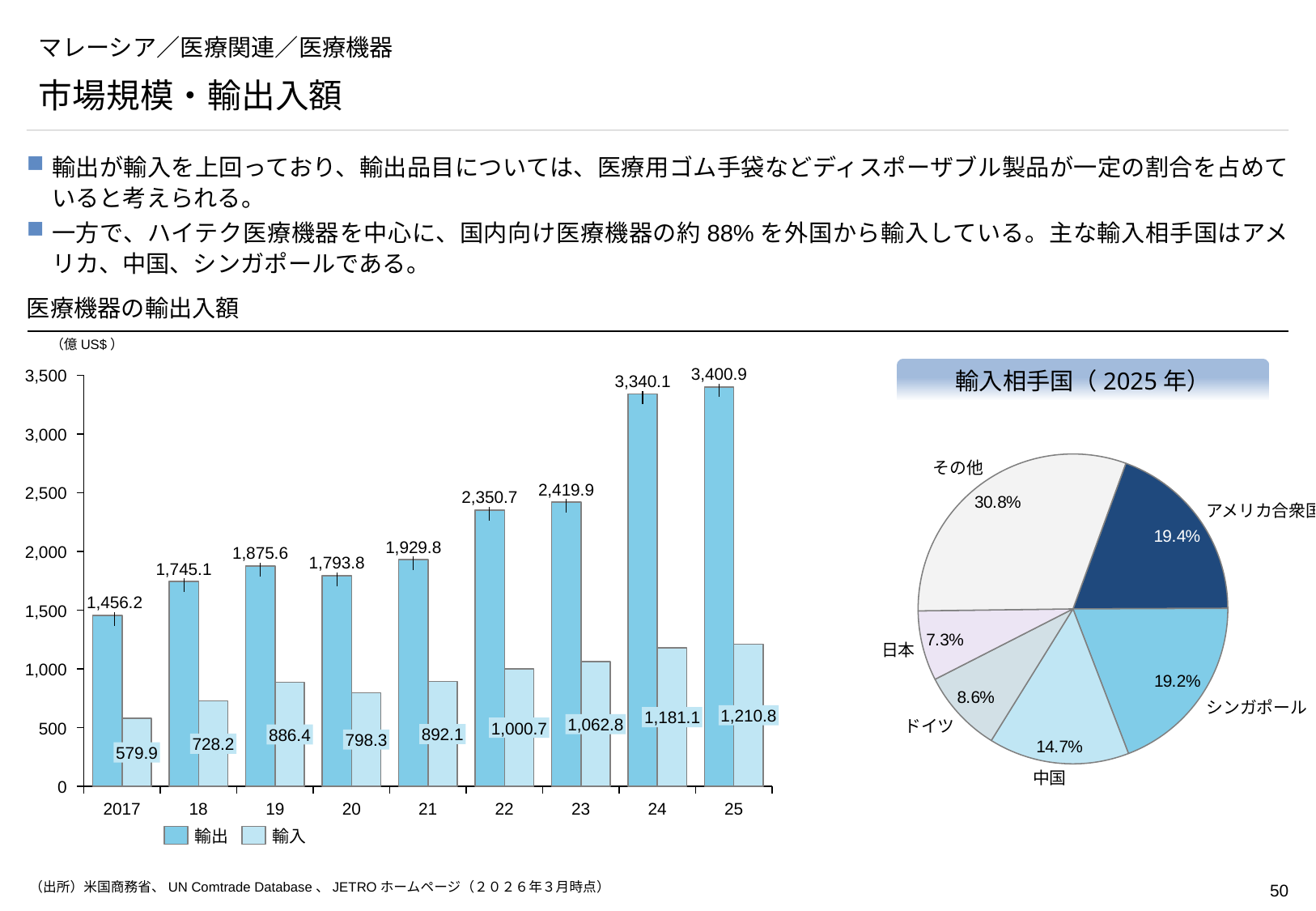
In the bar chart 医療機器の輸出入額, what is the difference between the 輸出 and 輸入 values for 24? 2,159.0 In the bar chart 医療機器の輸出入額, how many series does the legend list? 2 In the bar chart 医療機器の輸出入額, which is larger, the 輸出 value for 19 or the 輸出 value for 20? 19 In the bar chart 医療機器の輸出入額, which year has the lowest 輸入 value? 2017 In the bar chart 医療機器の輸出入額, what is the 輸出 value for 2017? 1,456.2 What kind of chart is 医療機器の輸出入額? bar chart In the bar chart 医療機器の輸出入額, how many years are shown on the x axis? 9 In the pie chart 輸入相手国（2025年）, what share does 中国 have? 14.7% In the pie chart 輸入相手国（2025年）, how many slices are there? 6 In the bar chart 医療機器の輸出入額, what is the 輸入 value for 25? 1,210.8 In the pie chart 輸入相手国（2025年）, which country (excluding その他) has the largest share? アメリカ合衆国 In the bar chart 医療機器の輸出入額, which year has the highest 輸出 value? 25